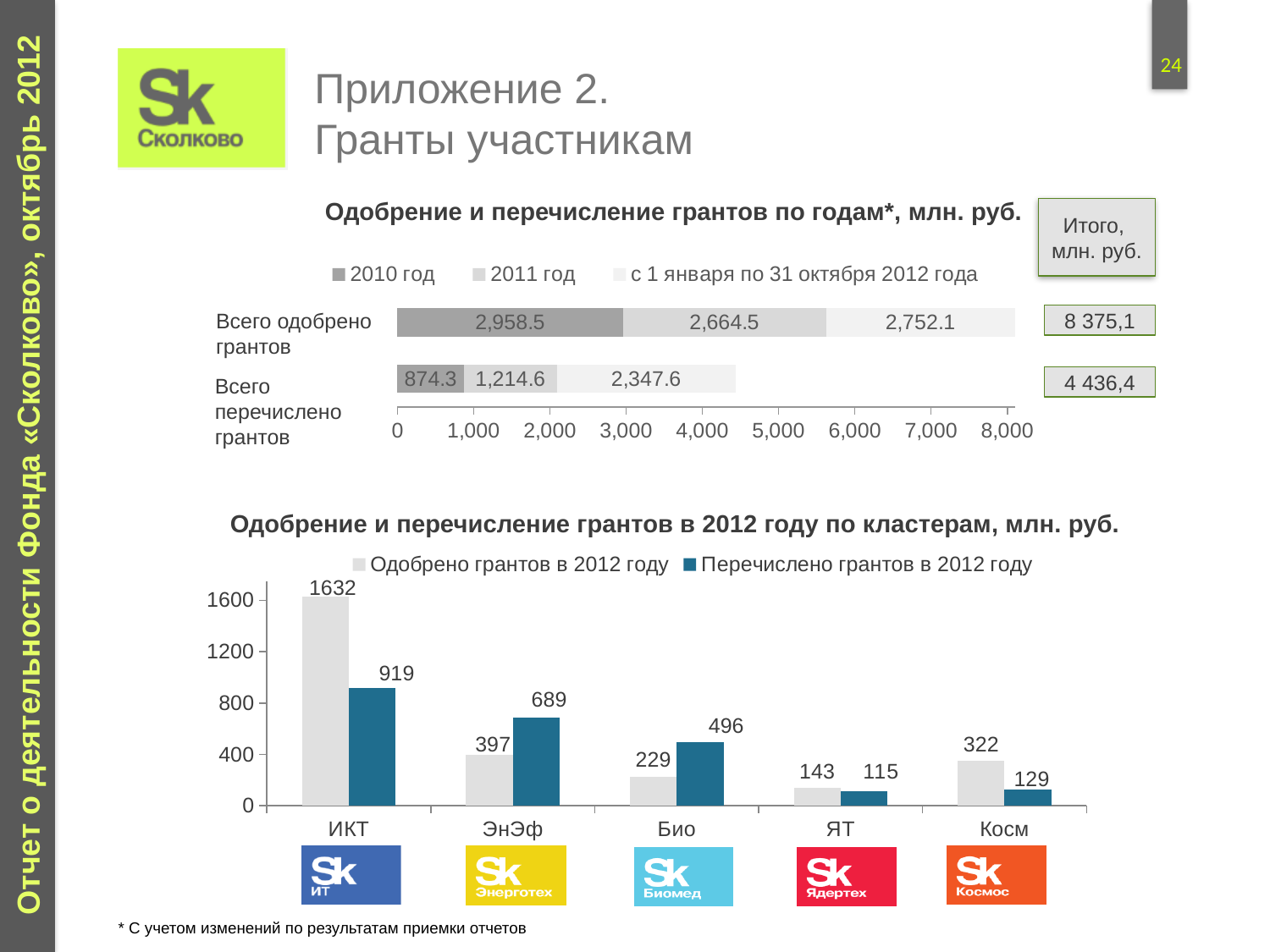
In the chart 'Одобрение и перечисление грантов по годам*, млн. руб.', what is the value for 'Всего перечислено грантов' for 'с 1 января по 31 октября 2012 года'? 2,347.6 In the chart 'Одобрение и перечисление грантов по годам*, млн. руб.', what is the 2010 год value for 'Всего одобрено грантов'? 2,958.5 In the chart 'Одобрение и перечисление грантов в 2012 году по кластерам, млн. руб.', what is the value of 'Одобрено грантов в 2012 году' for ИКТ? 1632 In the chart 'Одобрение и перечисление грантов в 2012 году по кластерам, млн. руб.', what is the difference between 'Одобрено грантов в 2012 году' and 'Перечислено грантов в 2012 году' for ИКТ? 713 In the chart 'Одобрение и перечисление грантов по годам*, млн. руб.', what is the total of the stacked bar for 'Всего перечислено грантов'? 4 436,4 In the chart 'Одобрение и перечисление грантов в 2012 году по кластерам, млн. руб.', which is larger for ЭнЭф: 'Одобрено грантов в 2012 году' or 'Перечислено грантов в 2012 году'? Перечислено грантов в 2012 году How many clusters are shown on the x axis of the chart 'Одобрение и перечисление грантов в 2012 году по кластерам, млн. руб.'? 5 In the chart 'Одобрение и перечисление грантов в 2012 году по кластерам, млн. руб.', what is the value of 'Перечислено грантов в 2012 году' for Био? 496 In the chart 'Одобрение и перечисление грантов в 2012 году по кластерам, млн. руб.', which cluster has the highest value of 'Одобрено грантов в 2012 году'? ИКТ In the chart 'Одобрение и перечисление грантов в 2012 году по кластерам, млн. руб.', which cluster has the lowest value of 'Перечислено грантов в 2012 году'? ЯТ In the chart 'Одобрение и перечисление грантов по годам*, млн. руб.', what is the difference between the 2011 год and 2010 год values for 'Всего перечислено грантов'? 340.3 How many series does the legend of the chart 'Одобрение и перечисление грантов по годам*, млн. руб.' list? 3